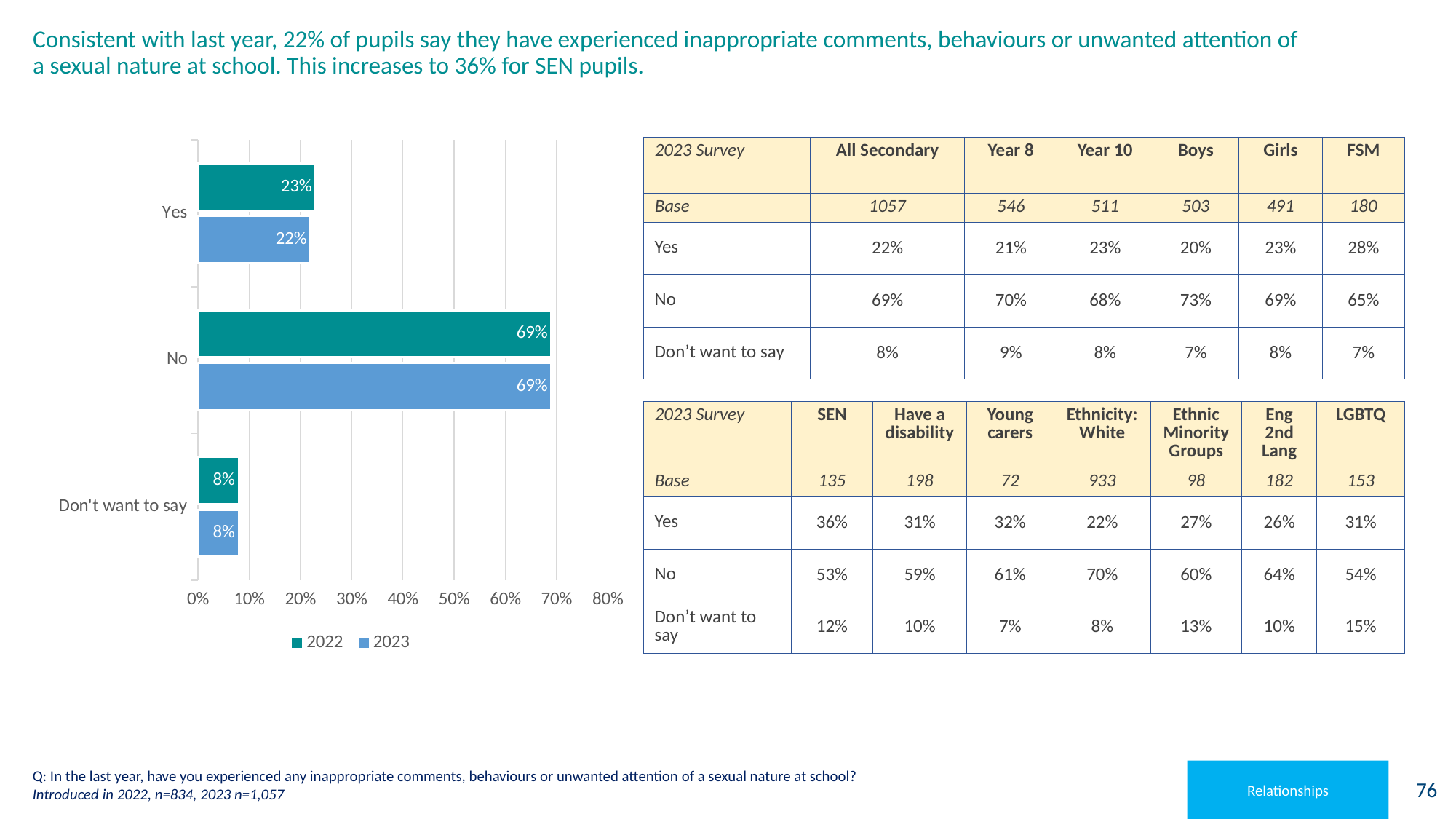
What kind of chart is shown on the slide? bar chart What is the 2022 value for 'Don't want to say' in the chart? 8% What is the 2023 value for 'Yes' in the chart? 22% What is the 2022 value for 'Yes' in the chart? 23% Which category has the lowest value for the 2022 series? Don't want to say Which series is shown in the darker teal colour in the chart? 2022 Which category has the highest value for the 2023 series? No How many categories are shown on the chart? 3 Is the 2023 value for 'No' greater or less than 60%? greater How many series does the chart legend list? 2 What is the difference between the 2022 and 2023 values for 'Yes'? 1% What is the 2023 value for 'No' in the chart? 69%